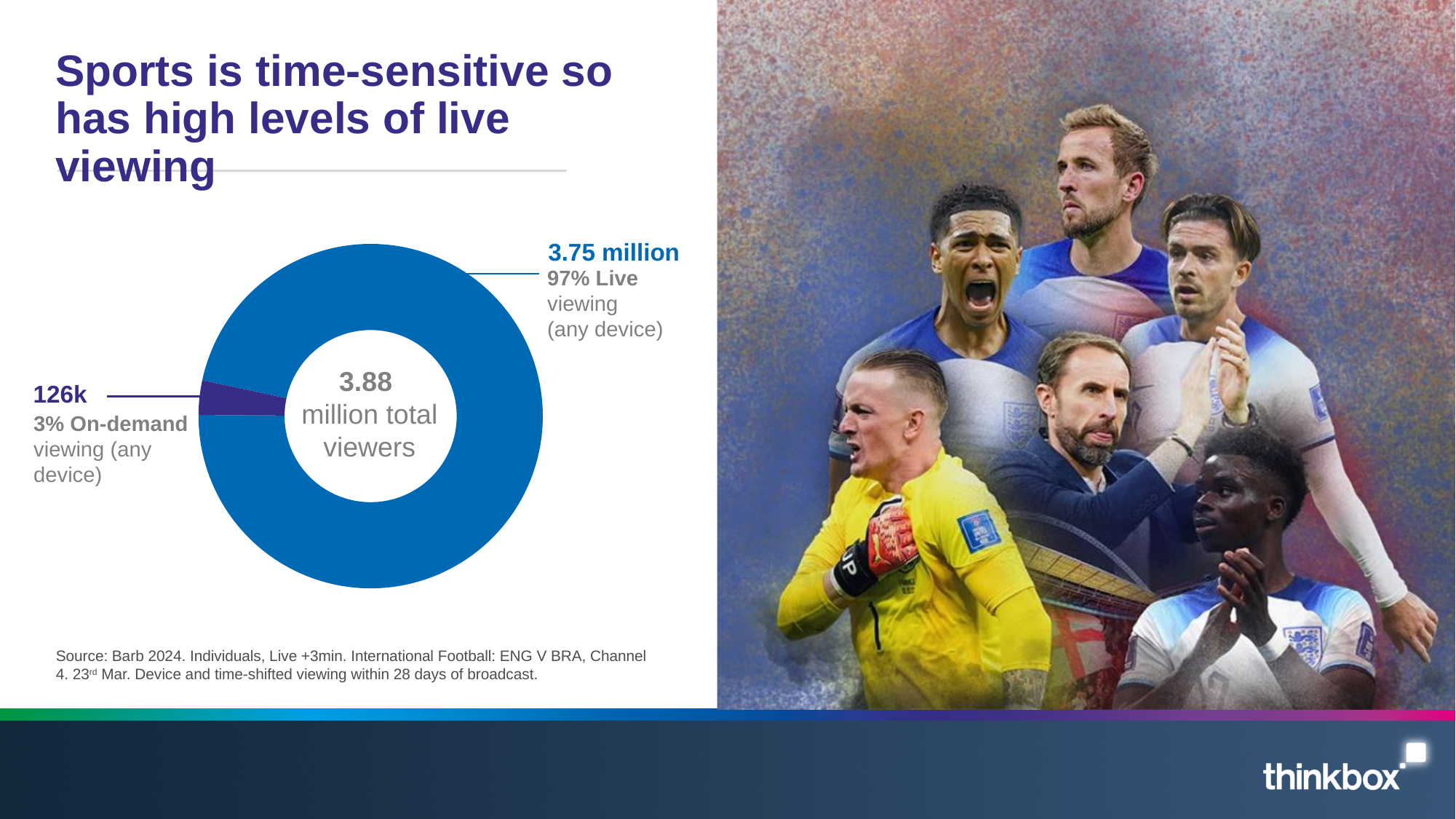
What colour is the Live viewing segment of the chart? Blue What is the total number of viewers shown in the centre of the chart? 3.88 million How many viewers does the On-demand viewing (any device) segment represent? 126k What kind of chart is shown on the slide? Doughnut chart What is the title of the slide containing the chart? Sports is time-sensitive so has high levels of live viewing What share of viewing is Live viewing (any device)? 97% How many viewers does the Live viewing (any device) segment represent? 3.75 million How many segments does the doughnut chart have? 2 Which segment is larger, Live viewing or On-demand viewing? Live viewing Which segment is the smallest in the chart? On-demand viewing (any device) What share of viewing is On-demand viewing (any device)? 3% What is the difference in percentage points between the Live and On-demand shares? 94 percentage points